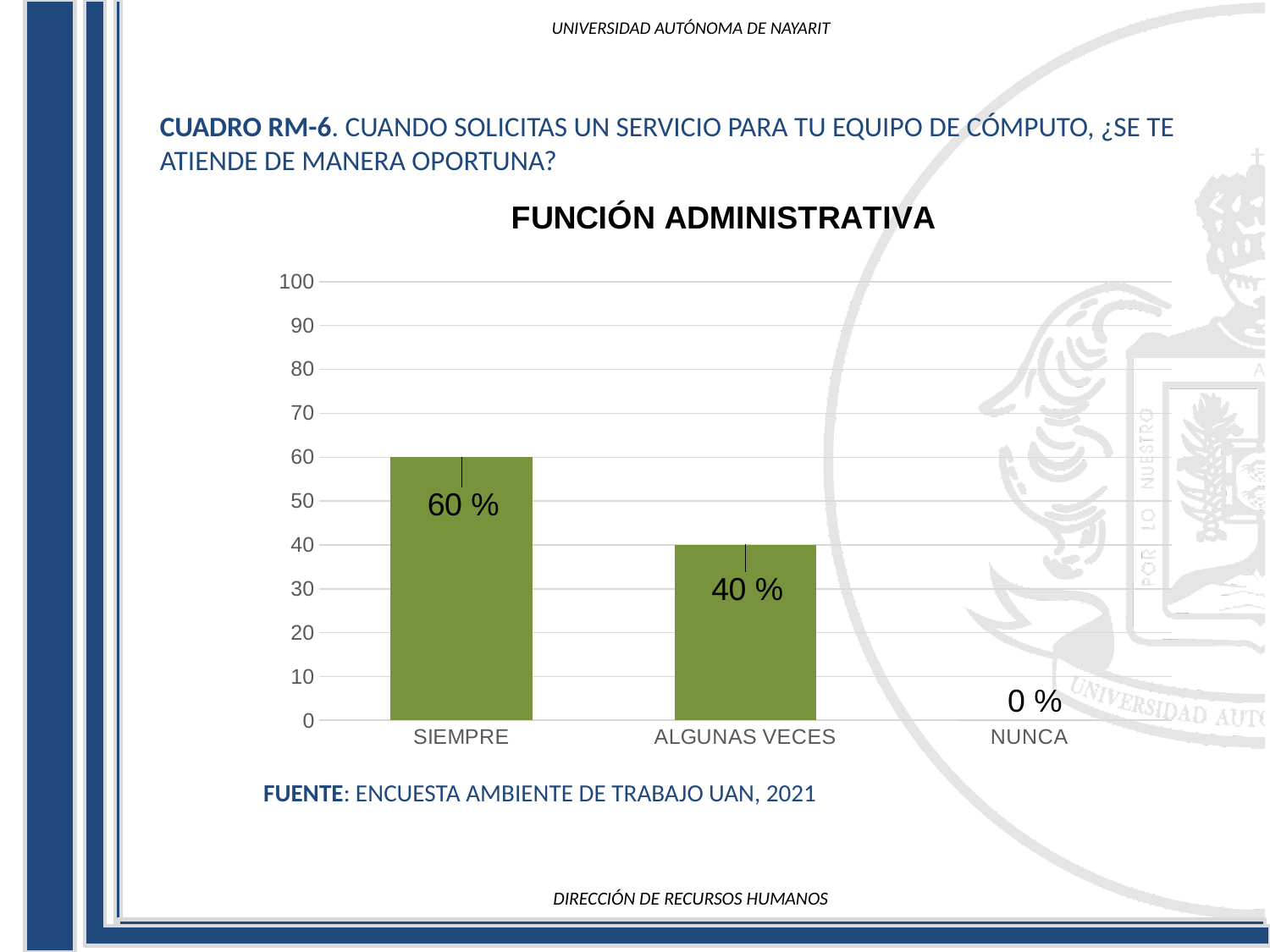
Do the values rise or fall from left to right along the x axis? fall What kind of chart is shown? bar chart What is the title of the chart? FUNCIÓN ADMINISTRATIVA How many categories are shown on the x axis? 3 What is the value for NUNCA? 0 % Which category has the lowest value? NUNCA Which is larger, the value for SIEMPRE or the value for ALGUNAS VECES? SIEMPRE Which category has the highest value? SIEMPRE What is the value for ALGUNAS VECES? 40 % What is the difference between the values for SIEMPRE and ALGUNAS VECES? 20 % What is the value for SIEMPRE? 60 % Is the value for ALGUNAS VECES greater or less than 50? less